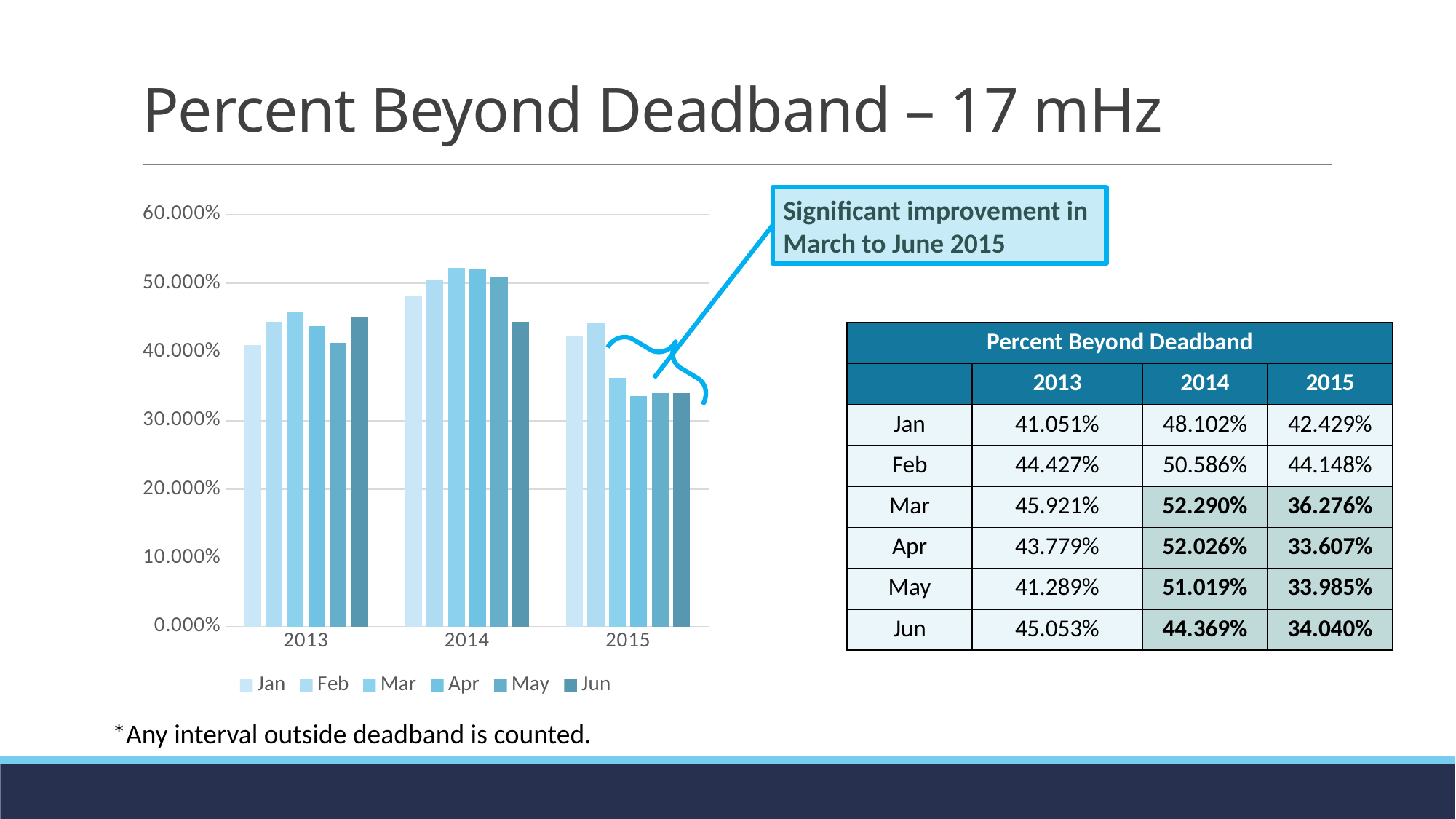
How many series does the chart legend list? 6 According to the slide, what is the Percent Beyond Deadband for January 2014? 48.102% What does the callout on the chart say? Significant improvement in March to June 2015 Which month in 2014 has the highest Percent Beyond Deadband? Mar How many year categories are shown on the x axis of the chart? 3 What is the difference between the Percent Beyond Deadband for March 2014 and March 2015? 16.014% What kind of chart is shown on the slide? bar chart Which is larger, the Percent Beyond Deadband for February 2014 or February 2015? February 2014 According to the slide, what is the Percent Beyond Deadband for March 2015? 36.276% According to the slide, what is the Percent Beyond Deadband for June 2013? 45.053% Is the Percent Beyond Deadband for April 2015 greater or less than 40.000%? less Which month in 2015 has the lowest Percent Beyond Deadband? Apr